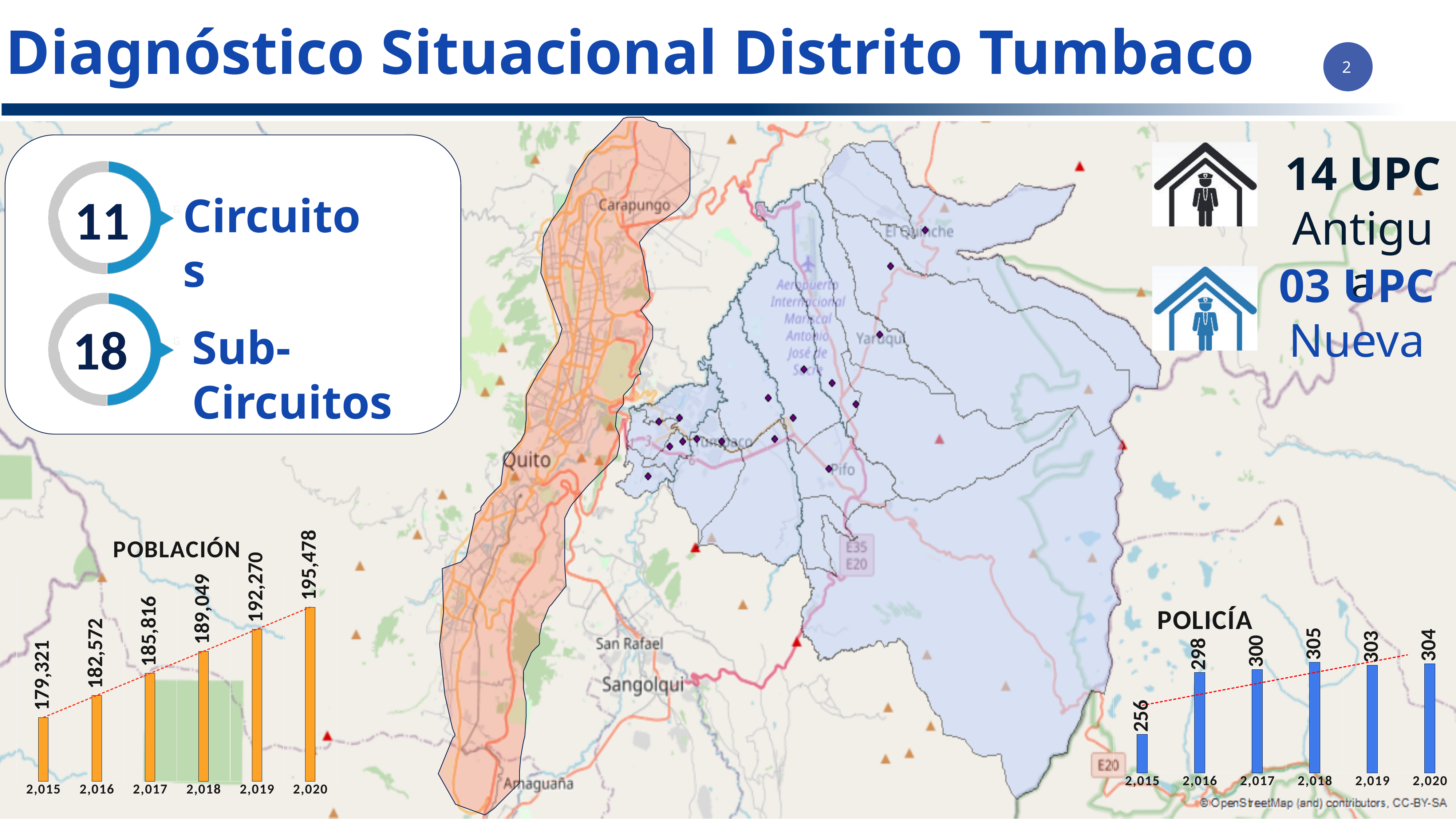
In the POLICÍA chart, what is the value for 2,015? 256 In the POLICÍA chart, which is larger, the value for 2,019 or the value for 2,020? 2,020 In the POLICÍA chart, what is the difference between the values for 2,016 and 2,015? 42 In the POBLACIÓN chart, what is the value for 2,020? 195,478 In the POBLACIÓN chart, do the values rise or fall from 2,015 to 2,020? rise What kind of chart is the POLICÍA chart? bar chart In the POBLACIÓN chart, what is the value for 2,015? 179,321 In the POBLACIÓN chart, how many bars are plotted? 6 In the POLICÍA chart, what is the value for 2,018? 305 In the POBLACIÓN chart, what is the difference between the values for 2,020 and 2,015? 16,157 In the POLICÍA chart, which year has the highest value? 2,018 In the POBLACIÓN chart, which year has the lowest value? 2,015